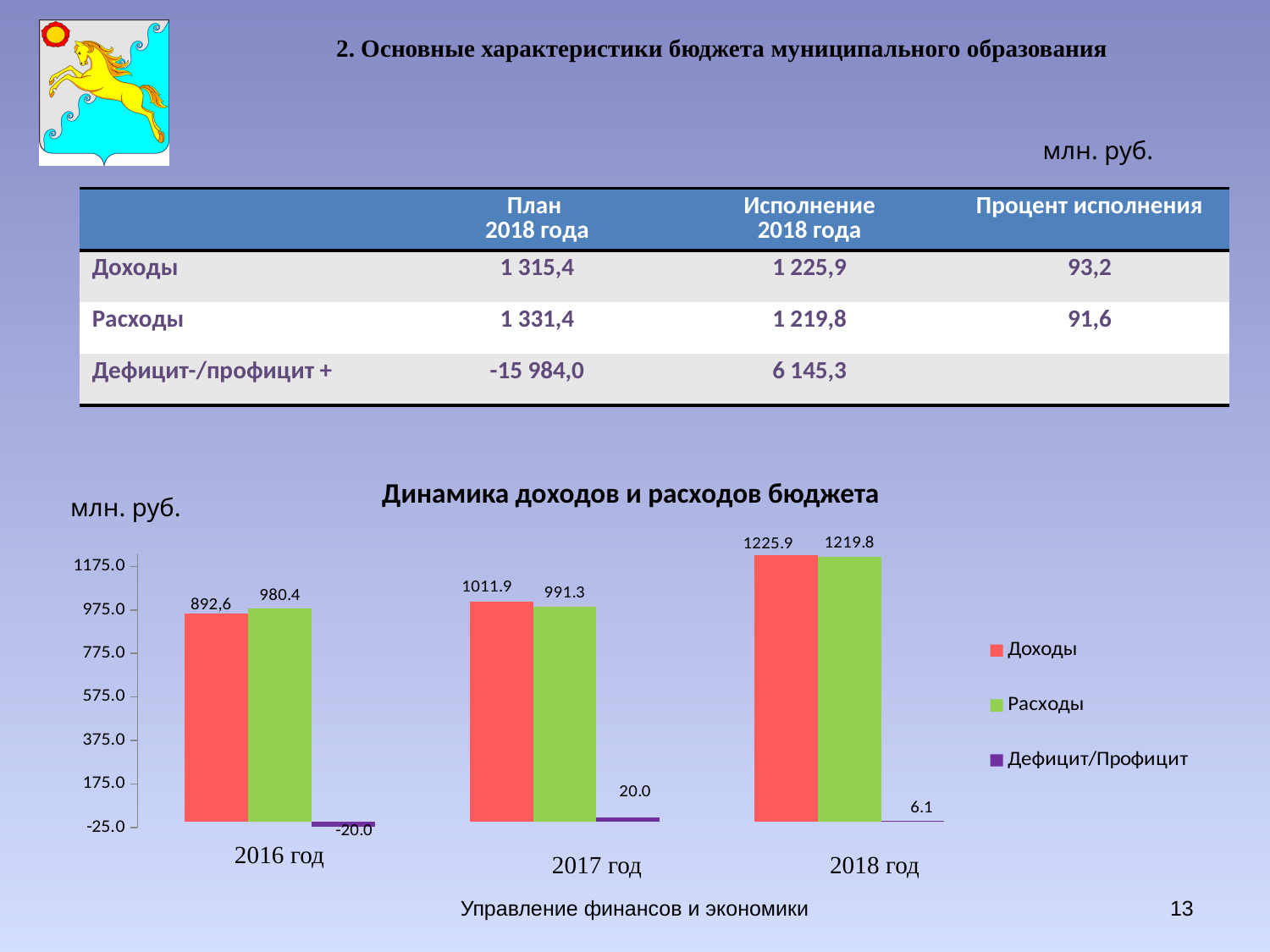
What type of chart is "Динамика доходов и расходов бюджета"? bar chart In which year is Доходы the highest? 2018 год Do the Доходы values rise or fall from 2016 год to 2018 год? rise What is the value of Доходы for 2016 год? 892,6 What is the value of Дефицит/Профицит for 2016 год? -20.0 What is the value of Расходы for 2017 год? 991.3 How many year categories are shown on the x axis of the chart? 3 What is the value of Дефицит/Профицит for 2018 год? 6.1 How many series does the legend of the chart list? 3 What is the difference between Доходы and Расходы in 2018 год? 6.1 In which year is Расходы the lowest? 2016 год Which is larger in 2016 год, Доходы or Расходы? Расходы